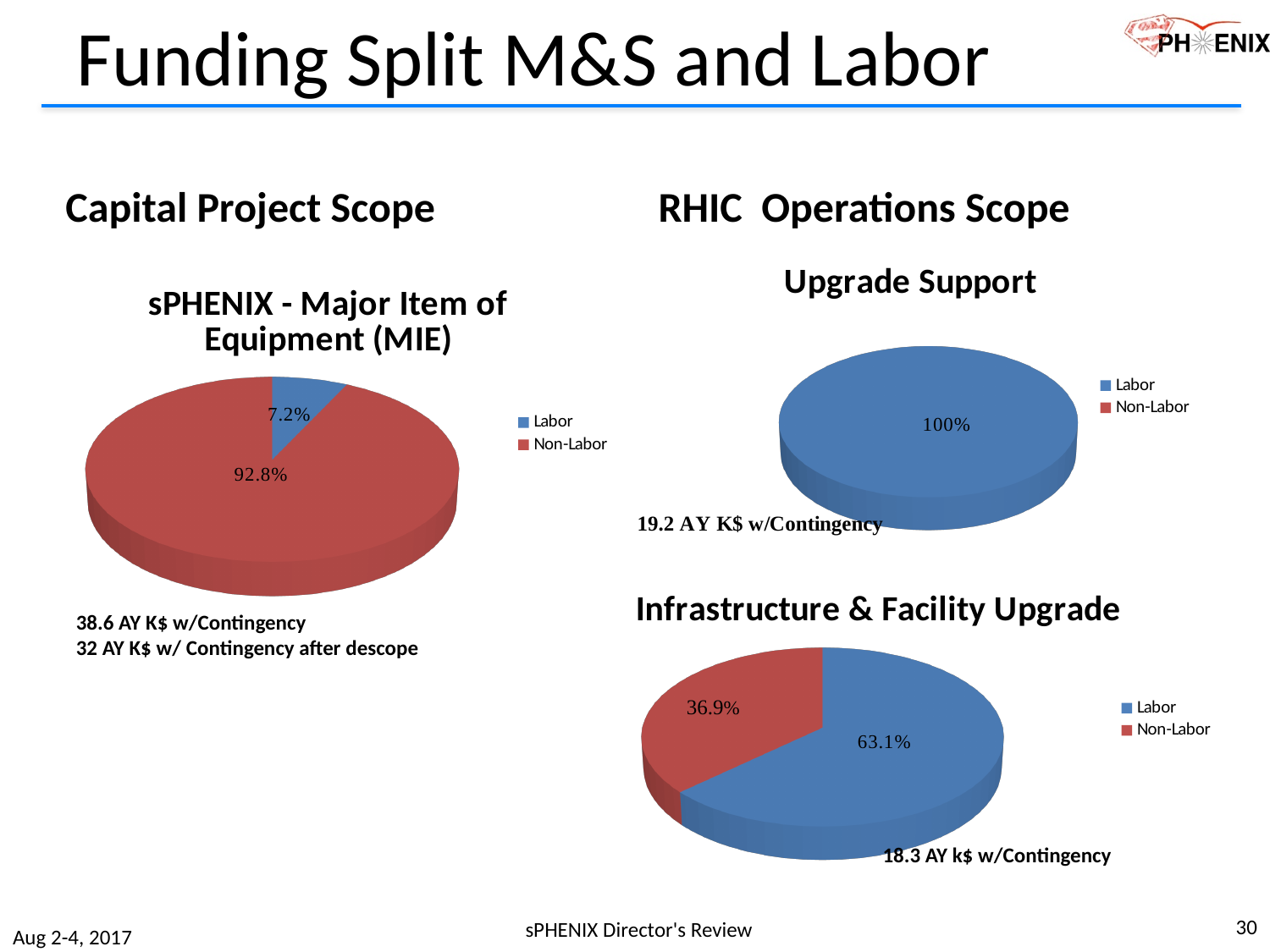
In the Infrastructure & Facility Upgrade chart, what share of the pie is Non-Labor? 36.9% In the sPHENIX - Major Item of Equipment (MIE) chart, which slice is larger, Labor or Non-Labor? Non-Labor In the Infrastructure & Facility Upgrade chart, what share of the pie is Labor? 63.1% In the Upgrade Support chart, what share of the pie is Labor? 100% What kind of chart is the Upgrade Support chart? Pie chart In the Infrastructure & Facility Upgrade chart, what is the difference between the Labor and Non-Labor shares? 26.2% In the sPHENIX - Major Item of Equipment (MIE) chart, what is the difference between the Non-Labor and Labor shares? 85.6% How many series does the legend of the Infrastructure & Facility Upgrade chart list? 2 In the Infrastructure & Facility Upgrade chart, what colour is the Non-Labor slice? Red In the Infrastructure & Facility Upgrade chart, which slice is the largest? Labor